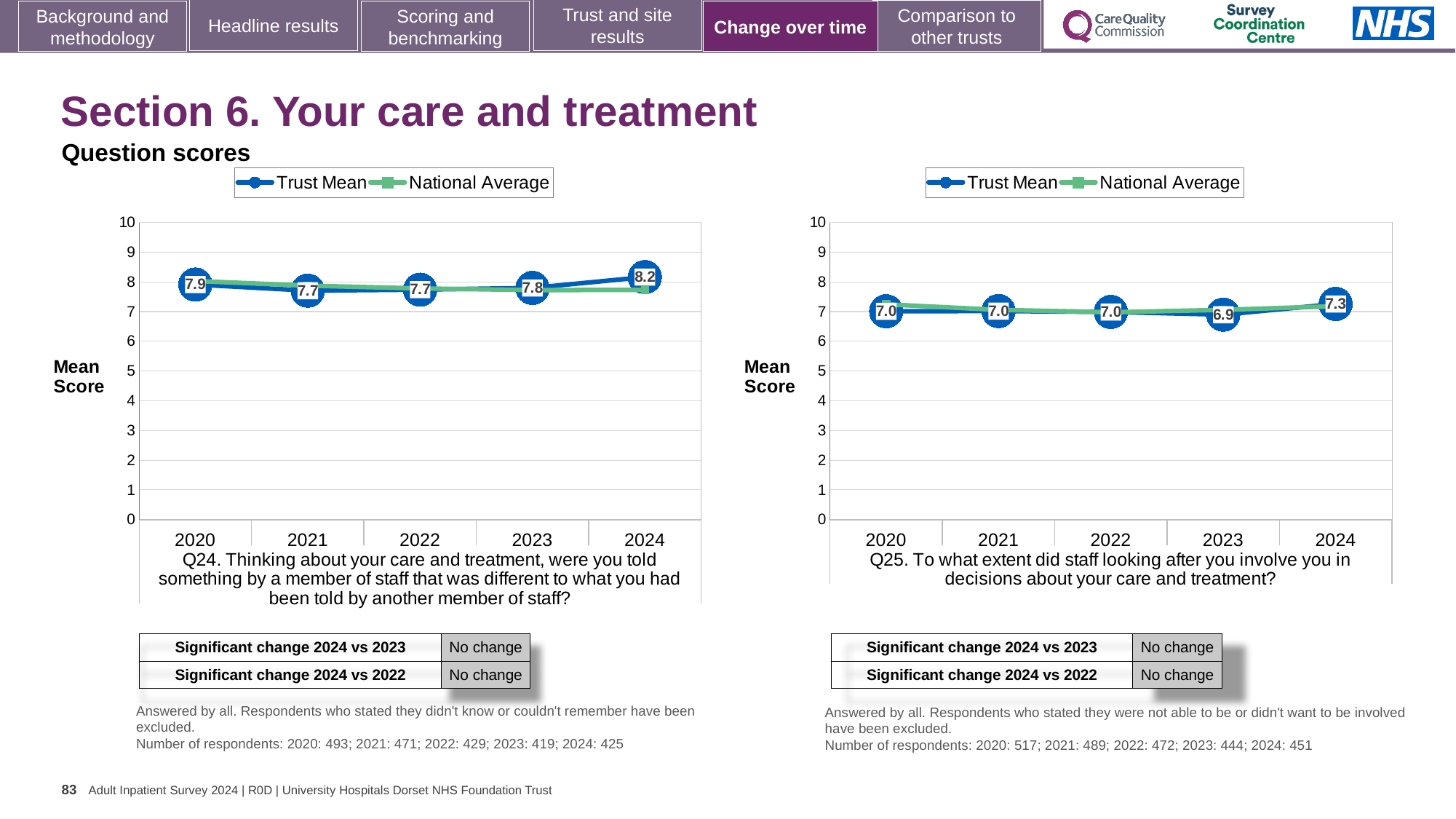
In the Q24 chart on the left, what is the difference between the Trust Mean scores for 2024 and 2023? 0.4 In the Q24 chart on the left, is the Trust Mean score for 2021 greater or less than 8? less In the Q25 chart on the right, which year has the highest Trust Mean score? 2024 In the Q25 chart on the right, what is the difference between the Trust Mean scores for 2024 and 2023? 0.4 How many years are shown on the x axis of the Q25 chart on the right? 5 In the Q24 chart on the left, what is the Trust Mean score for 2020? 7.9 In the Q24 chart on the left, what is the Trust Mean score for 2024? 8.2 In the Q25 chart on the right, which year has the lowest Trust Mean score? 2023 In the Q24 chart on the left, which year has the highest Trust Mean score? 2024 In the Q25 chart on the right, what is the Trust Mean score for 2023? 6.9 How many series does the legend of the Q24 chart on the left list? 2 What kind of chart is the Q25 chart on the right? Line chart